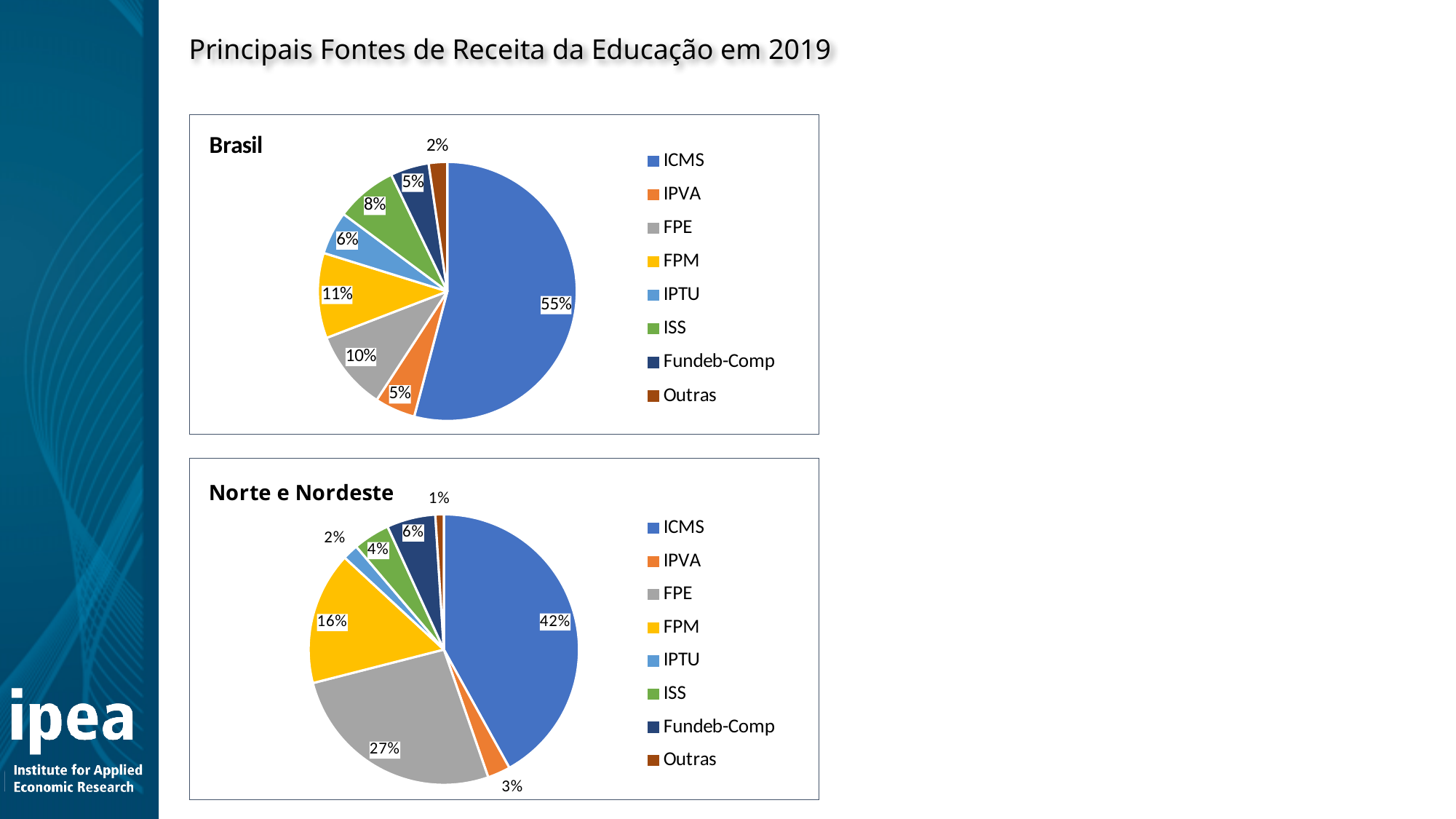
What is the title of the slide? Principais Fontes de Receita da Educação em 2019 How many sources does the legend of the Brasil chart list? 8 In the Brasil chart, what share does ICMS have? 55% In the Norte e Nordeste chart, what share does Fundeb-Comp have? 6% In the Norte e Nordeste chart, what share does FPE have? 27% In the Norte e Nordeste chart, which source has the largest share? ICMS What kind of chart is the Norte e Nordeste chart? Pie chart What is the difference between the ICMS share in the Brasil chart and the ICMS share in the Norte e Nordeste chart? 13 percentage points In the Brasil chart, what share does FPM have? 11% In the Brasil chart, which source has the smallest share? Outras In the Norte e Nordeste chart, which source has the smallest share? Outras In the Brasil chart, which is larger: the share of FPE or the share of ISS? FPE